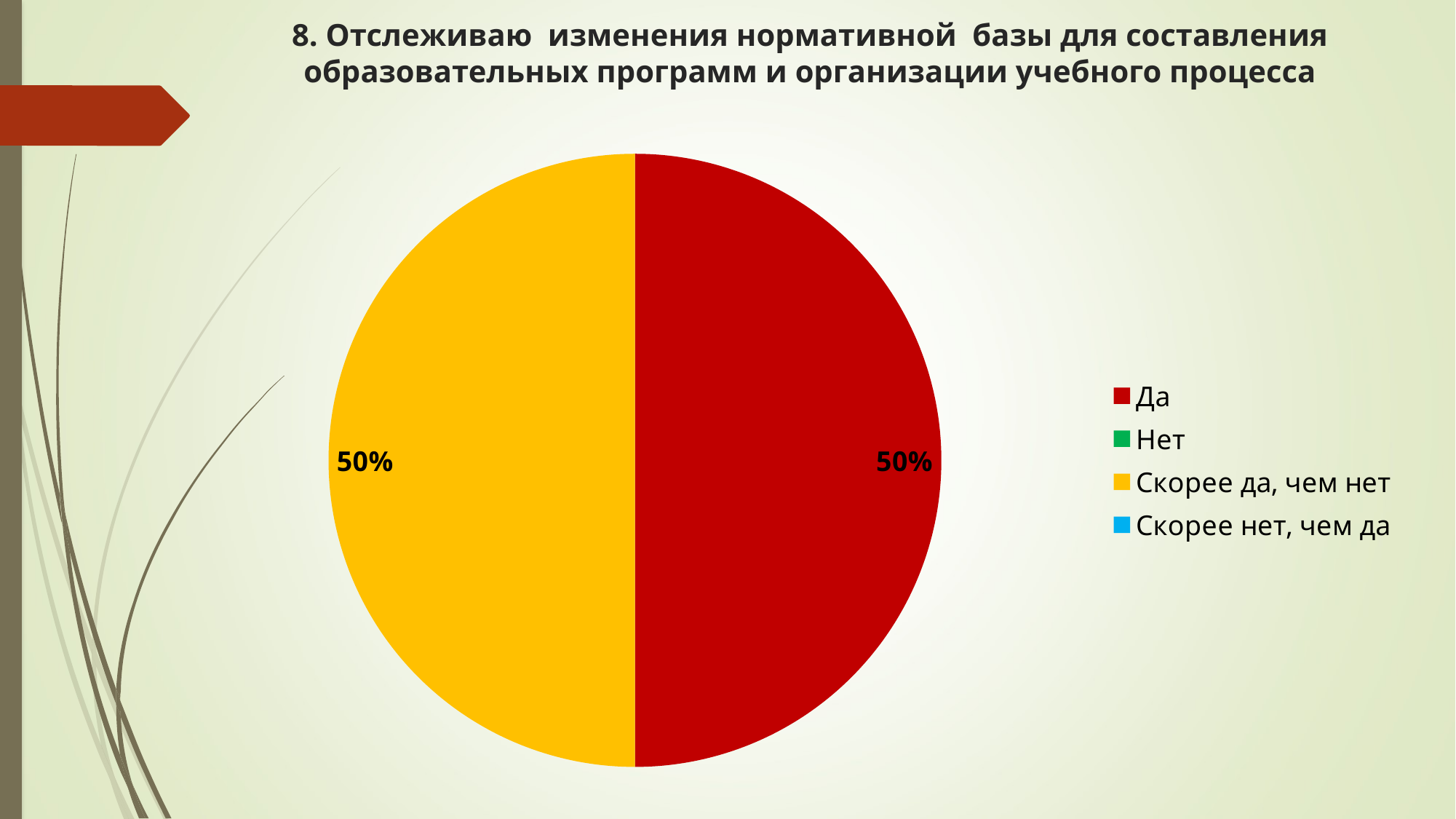
How many slices are visible in the pie chart? 2 How many entries does the legend list? 4 What kind of chart is shown on the slide? pie chart What is the difference between the "Да" share and the "Скорее да, чем нет" share? 0% What share of the pie does the "Да" slice take? 50% What colour is the "Да" slice in the pie chart? red What colour is the "Скорее да, чем нет" slice in the pie chart? yellow What percentage of the pie is labelled for the "Скорее да, чем нет" slice? 50% What is the combined share of the "Да" and "Скорее да, чем нет" slices? 100% What percentage of the pie is labelled for the "Да" slice? 50%